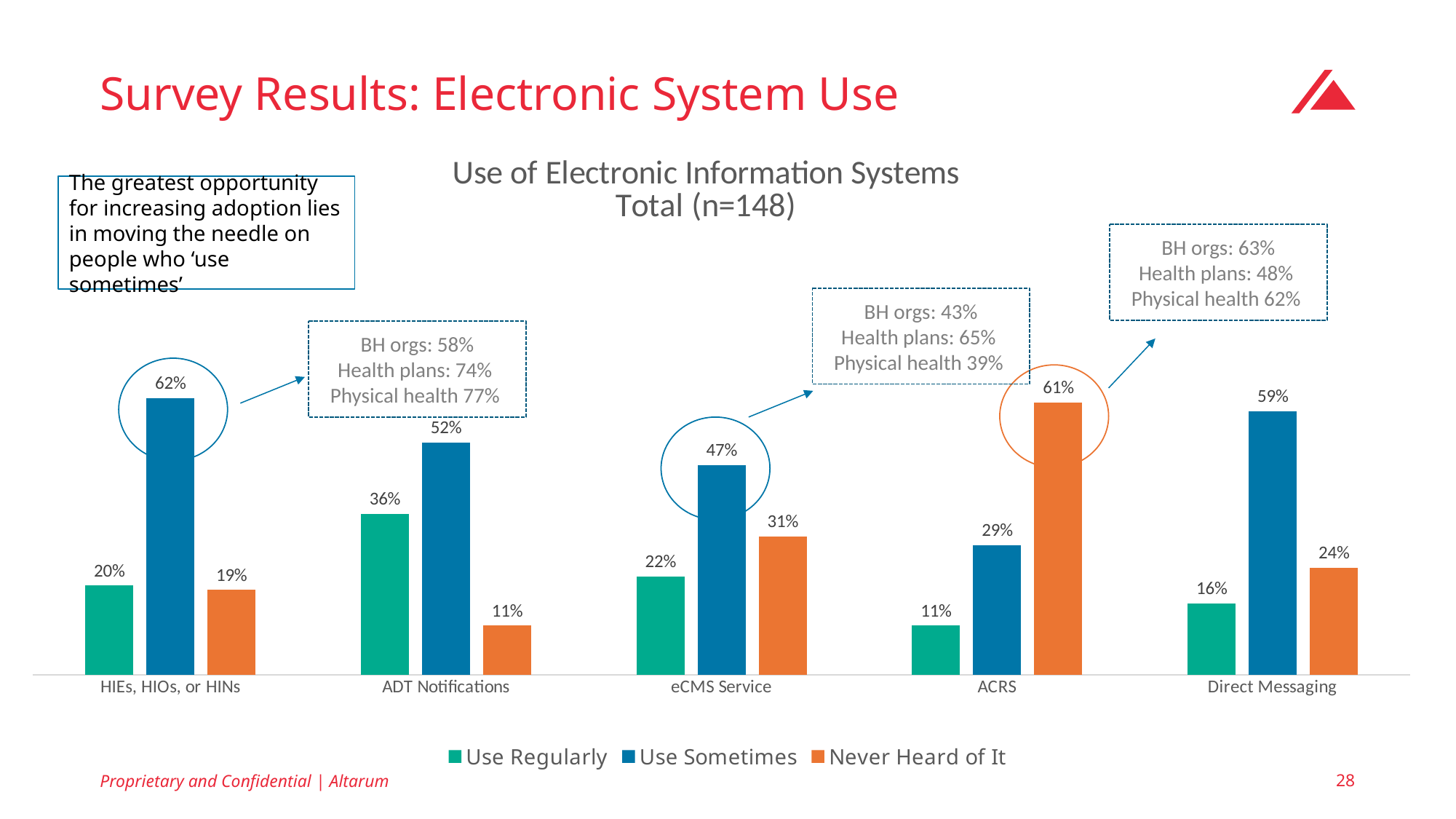
What is the 'Never Heard of It' value for ACRS? 61% Which category has the highest 'Use Regularly' value? ADT Notifications How many categories are shown on the x axis? 5 What is the 'Use Sometimes' value for HIEs, HIOs, or HINs? 62% What is the title of the chart? Use of Electronic Information Systems Total (n=148) What is the difference between the 'Use Sometimes' and 'Use Regularly' values for Direct Messaging? 43% What kind of chart is shown on the slide? Bar chart Which series is shown in orange in the legend? Never Heard of It What is the 'Use Regularly' value for ADT Notifications? 36% Which category has the lowest 'Never Heard of It' value? ADT Notifications For eCMS Service, which is larger: 'Use Sometimes' or 'Never Heard of It'? Use Sometimes How many series does the legend list? 3